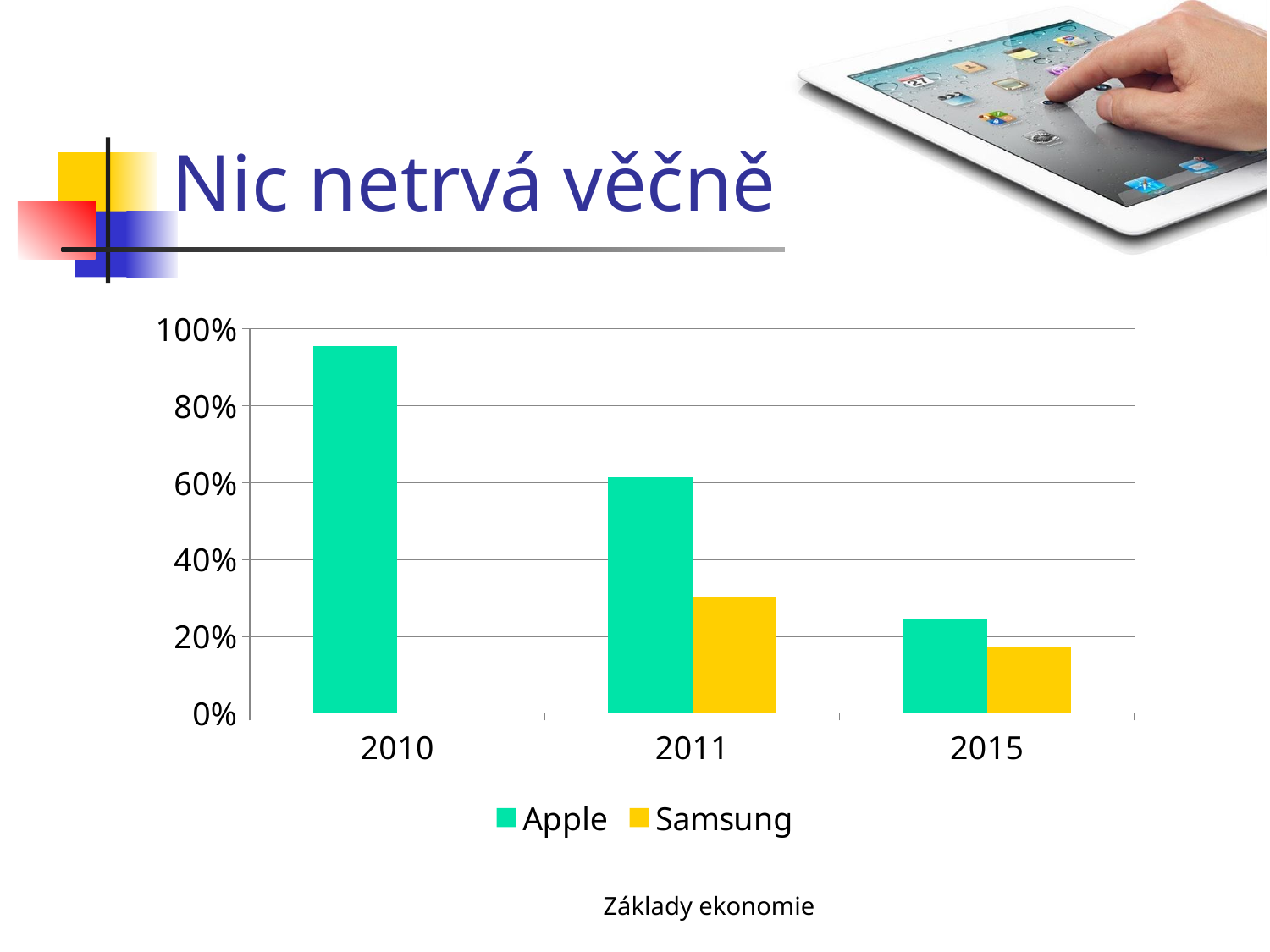
Which series is shown in green? Apple How many series does the legend list? 2 Do the Apple values rise or fall from 2010 to 2015? fall In which year is the Apple value highest? 2010 In 2011, which is larger, Apple or Samsung? Apple What kind of chart is shown on the slide? bar chart Is the value for Apple in 2015 greater or less than 40%? less Is the value for Apple in 2010 greater or less than 80%? greater How many years are shown on the x axis? 3 Is the value for Samsung in 2011 greater or less than 40%? less In which year is the Apple value lowest? 2015 In 2015, which is larger, Apple or Samsung? Apple